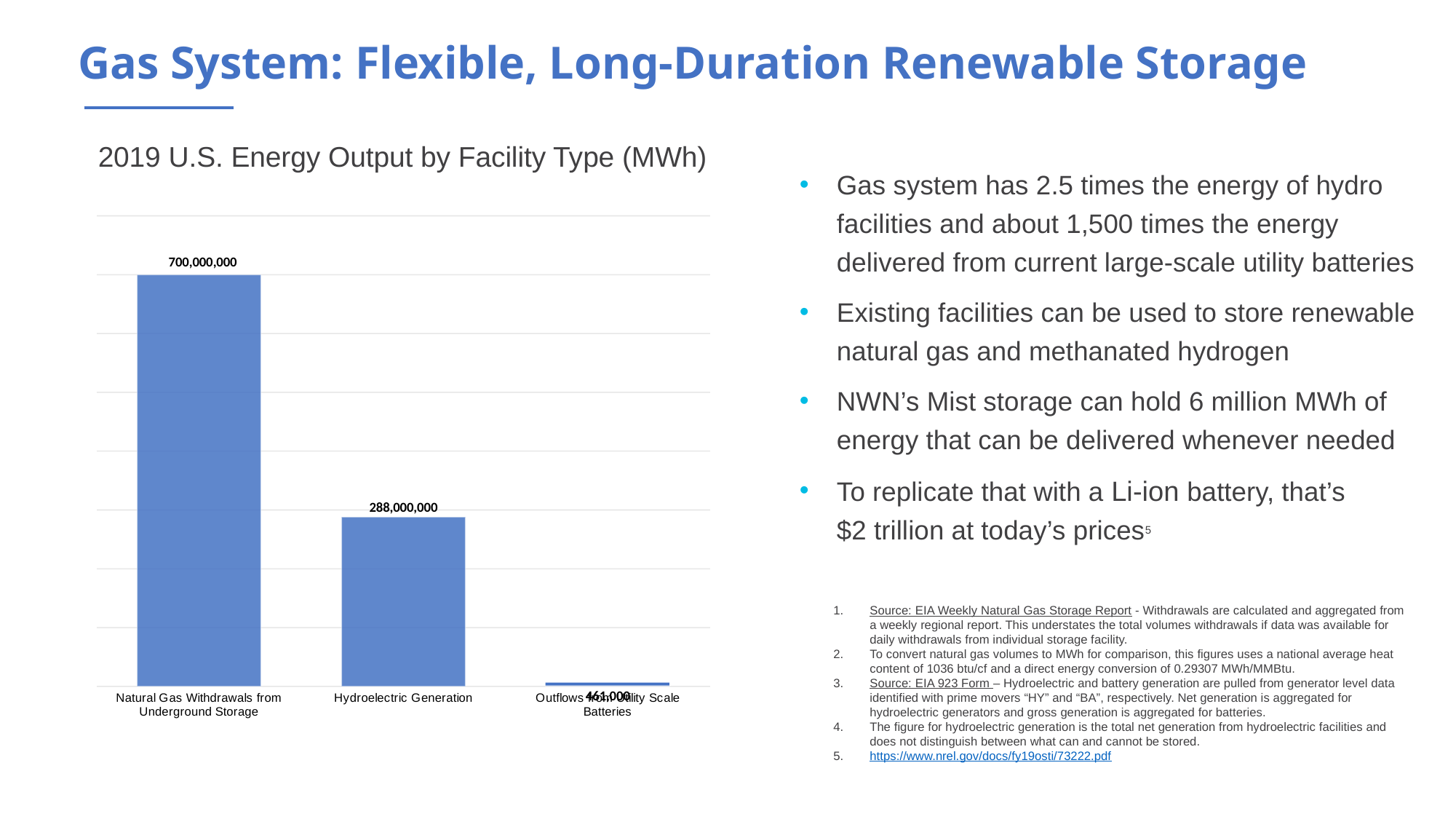
What is the value for Natural Gas Withdrawals from Underground Storage? 700,000,000 Which facility type has the highest energy output? Natural Gas Withdrawals from Underground Storage What is the difference between the values for Natural Gas Withdrawals from Underground Storage and Hydroelectric Generation? 412,000,000 Which facility type has the lowest energy output? Outflows from Utility Scale Batteries How many facility types are shown in the chart? 3 Do the values rise or fall from left to right across the categories? Fall Which is larger, the value for Hydroelectric Generation or the value for Outflows from Utility Scale Batteries? Hydroelectric Generation What is the value for Outflows from Utility Scale Batteries? 461,000 What kind of chart is shown on the slide? Bar chart What is the value for Hydroelectric Generation? 288,000,000 What is the difference between the values for Hydroelectric Generation and Outflows from Utility Scale Batteries? 287,539,000 What is the title of the chart? 2019 U.S. Energy Output by Facility Type (MWh)